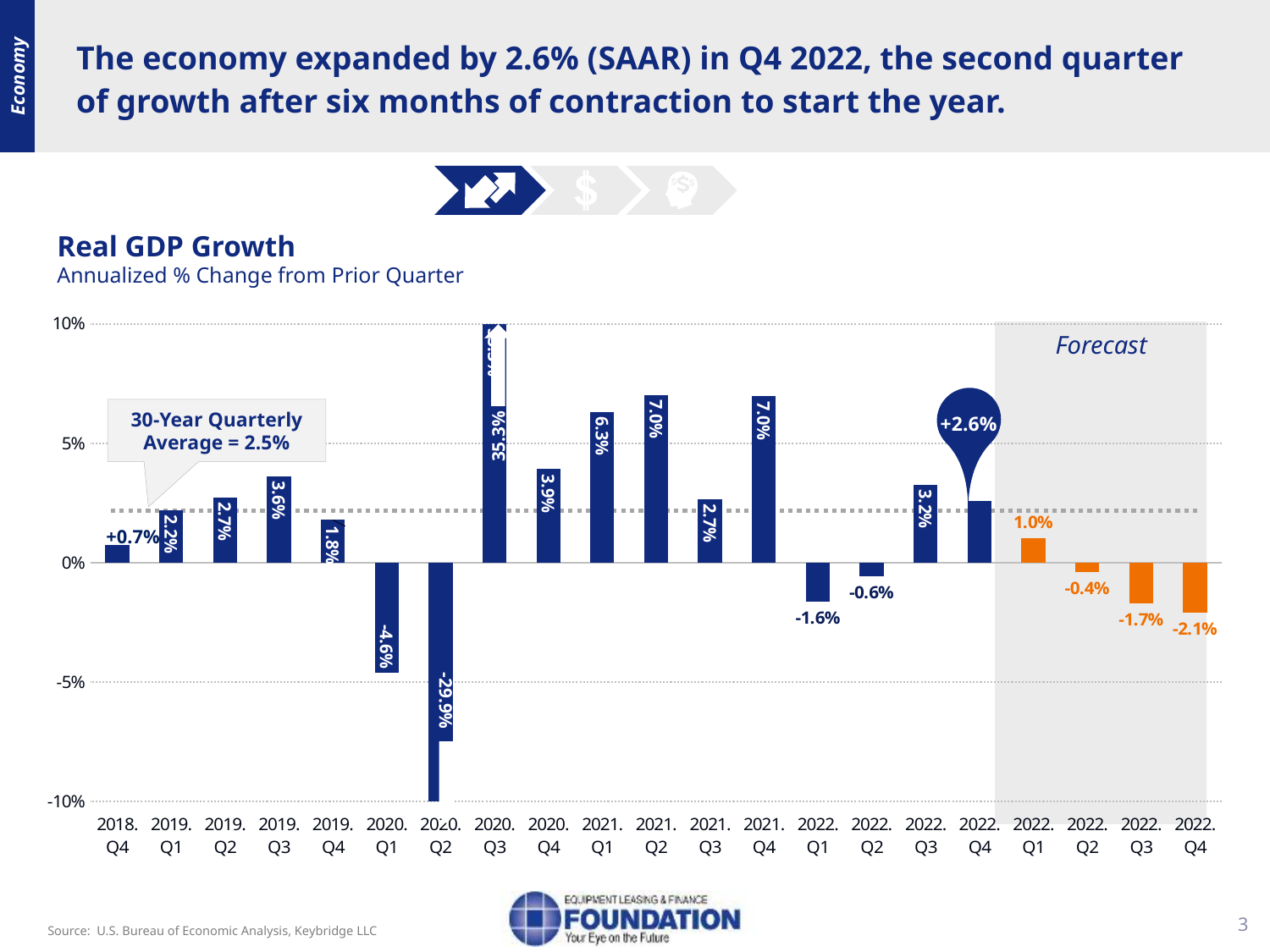
Which quarter has the lowest Real GDP Growth value? 2020 Q2 What is the Real GDP Growth value for 2020 Q2? -29.9% How many bars are plotted in the Real GDP Growth chart? 21 What is the Real GDP Growth value for 2020 Q3? 35.3% What is the 30-Year Quarterly Average shown in the callout box on the chart? 2.5% What is the difference between the Real GDP Growth values for 2021 Q1 and 2020 Q4? 2.4 percentage points Which quarter has the highest Real GDP Growth value? 2020 Q3 Which is larger, the Real GDP Growth value for 2019 Q3 or for 2019 Q4? 2019 Q3 What is the Real GDP Growth value for 2022 Q1 (the first non-forecast 2022 bar)? -1.6% What is the Real GDP Growth value highlighted in the callout for 2022 Q4? +2.6% What kind of chart is used to show Real GDP Growth? bar chart What is the value of the last orange forecast bar on the right of the chart? -2.1%